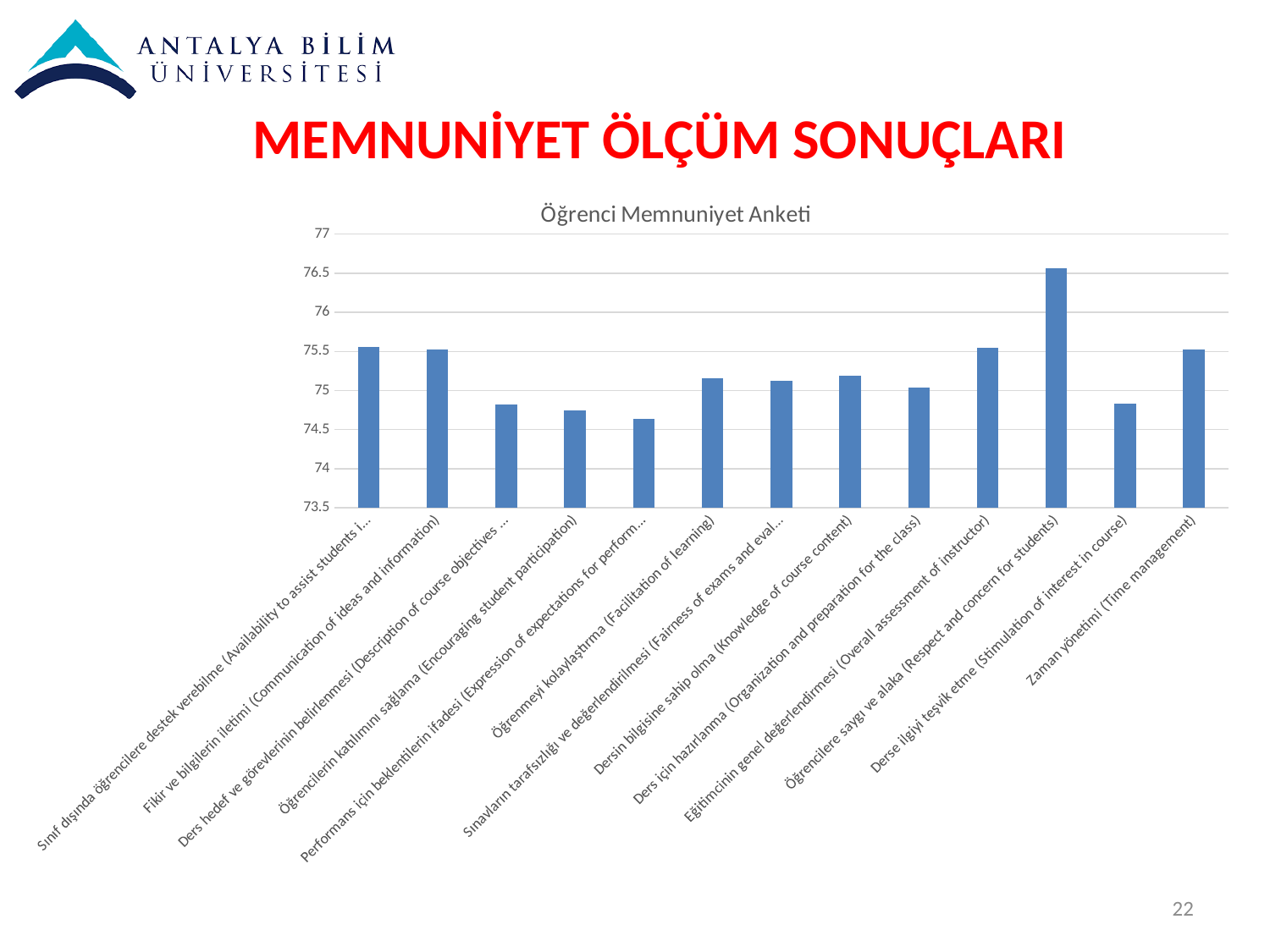
What is the title of the chart? Öğrenci Memnuniyet Anketi Is the value for Öğrencilerin katılımını sağlama (Encouraging student participation) greater or less than 75? less Which is larger: the value for Öğrencilere saygı ve alaka (Respect and concern for students) or for Zaman yönetimi (Time management)? Öğrencilere saygı ve alaka (Respect and concern for students) Is the value for Öğrencilere saygı ve alaka (Respect and concern for students) greater or less than 76? greater Which is larger: the value for Dersin bilgisine sahip olma (Knowledge of course content) or for Derse ilgiyi teşvik etme (Stimulation of interest in course)? Dersin bilgisine sahip olma (Knowledge of course content) Which category has the highest value in the chart? Öğrencilere saygı ve alaka (Respect and concern for students) Is the value for Derse ilgiyi teşvik etme (Stimulation of interest in course) greater or less than 75? less How many categories are plotted in the chart? 13 Which category has the lowest value in the chart? Performans için beklentilerin ifadesi (Expression of expectations for performance) What type of chart is shown on the slide? bar chart